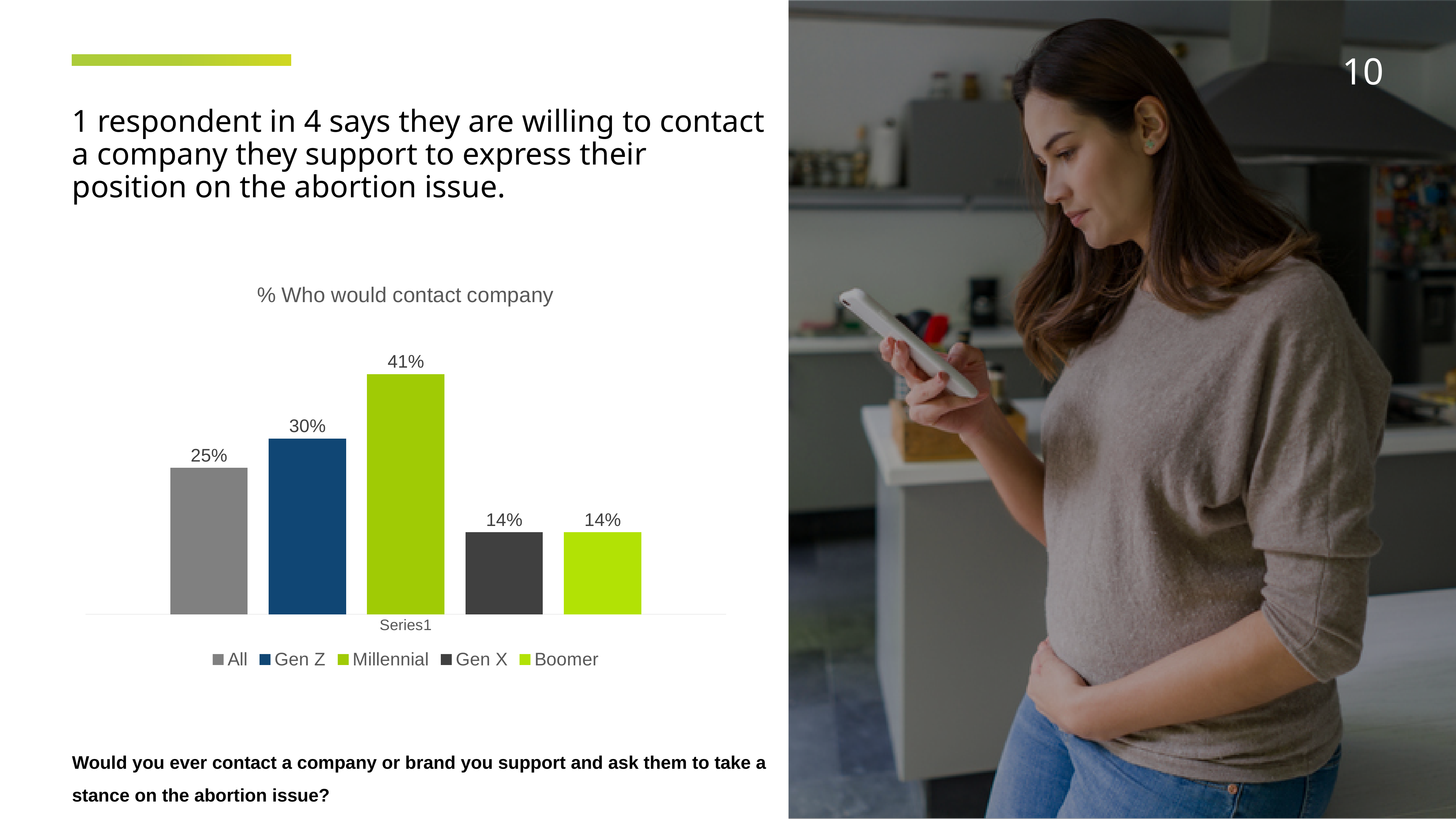
What is the difference between the Millennial and Gen Z values? 11% What is the value for All in the chart? 25% What colour is the Gen Z bar in the chart? Blue What is the value for Gen Z in the chart? 30% What is the difference between the Gen Z and Gen X values? 16% What is the title of the chart? % Who would contact company Which group has the highest percentage who would contact a company? Millennial What kind of chart is shown on the slide? Bar chart What is the value for Boomer in the chart? 14% Which is larger, the value for Gen Z or the value for All? Gen Z How many series does the legend list? 5 What is the value for Millennial in the chart? 41%